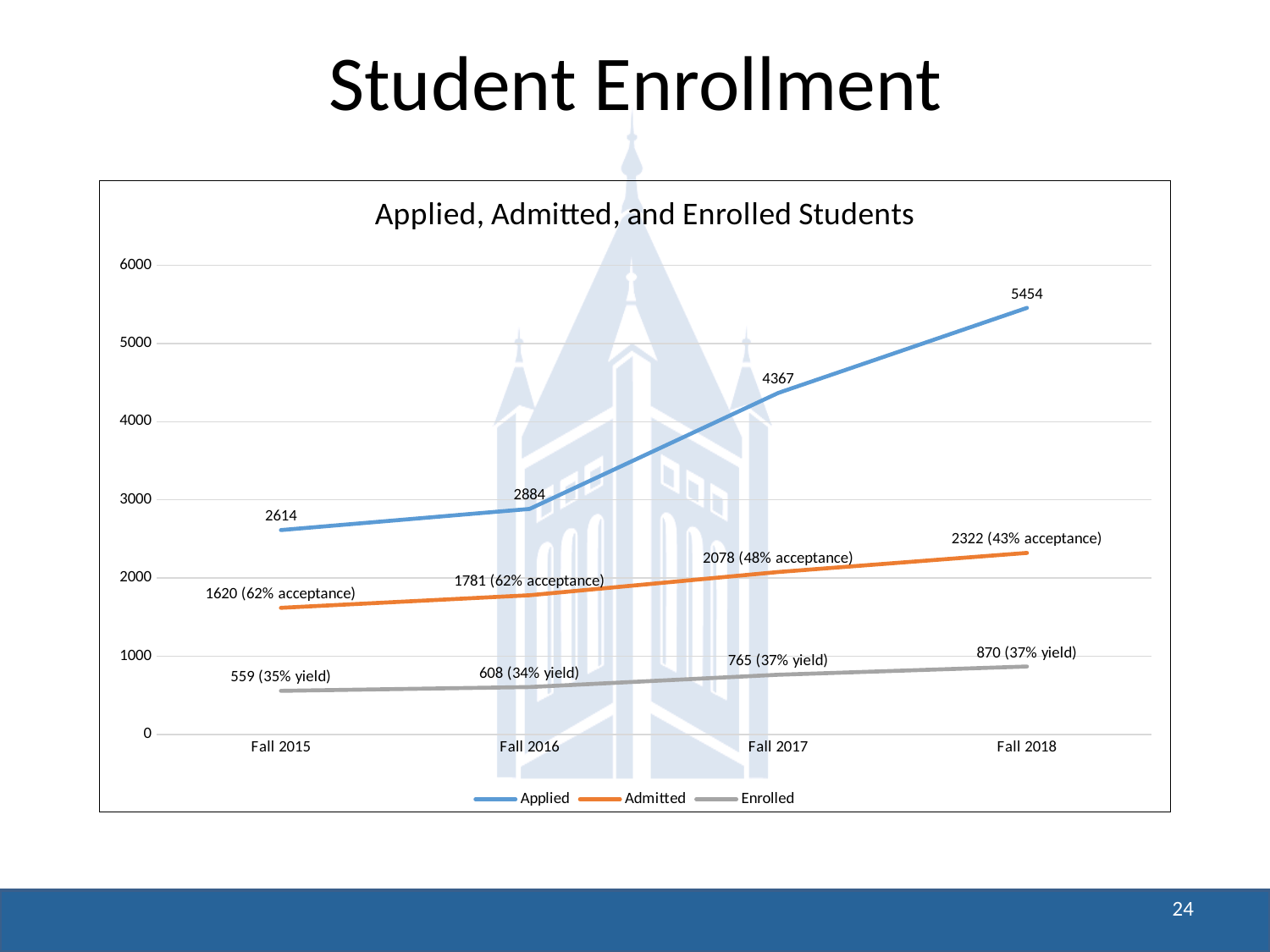
How many series does the legend list? 3 Which is larger: Admitted students in Fall 2017 or Applied students in Fall 2015? Applied students in Fall 2015 Is the number of Applied students in Fall 2017 greater or less than 4000? greater What kind of chart is shown? Line chart What acceptance rate is shown for Fall 2018? 43% In which term is the number of Applied students highest? Fall 2018 How many terms are shown on the x axis? 4 What is the number of Enrolled students in Fall 2017? 765 What is the difference between Applied students in Fall 2018 and Fall 2017? 1087 What is the number of Applied students in Fall 2018? 5454 What is the number of Admitted students in Fall 2016? 1781 In which term is the number of Enrolled students lowest? Fall 2015